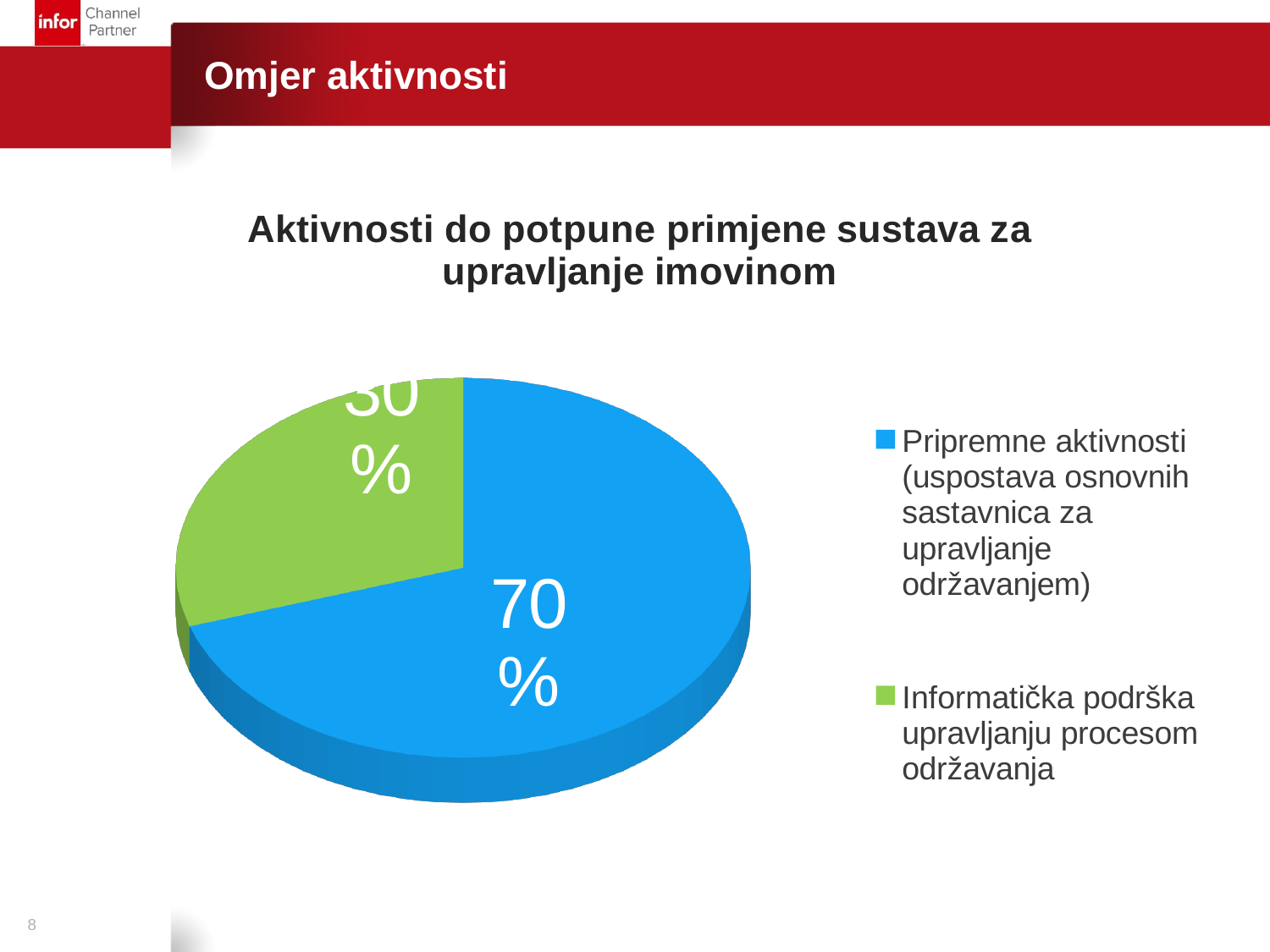
What kind of chart is shown on the slide? pie chart Which is larger: the slice for "Pripremne aktivnosti" or the slice for "Informatička podrška upravljanju procesom održavanja"? Pripremne aktivnosti How many categories does the pie chart have? 2 Which category has the largest slice of the pie? Pripremne aktivnosti (uspostava osnovnih sastavnica za upravljanje održavanjem) What is the difference in percentage points between the "Pripremne aktivnosti" slice and the "Informatička podrška" slice? 40 percentage points How many entries does the legend list? 2 What share of the pie does "Pripremne aktivnosti (uspostava osnovnih sastavnica za upravljanje održavanjem)" represent? 70% What colour is the slice for "Informatička podrška upravljanju procesom održavanja"? green What share of the pie does "Informatička podrška upravljanju procesom održavanja" represent? 30% Which category has the smallest slice of the pie? Informatička podrška upravljanju procesom održavanja What is the title of the chart? Aktivnosti do potpune primjene sustava za upravljanje imovinom